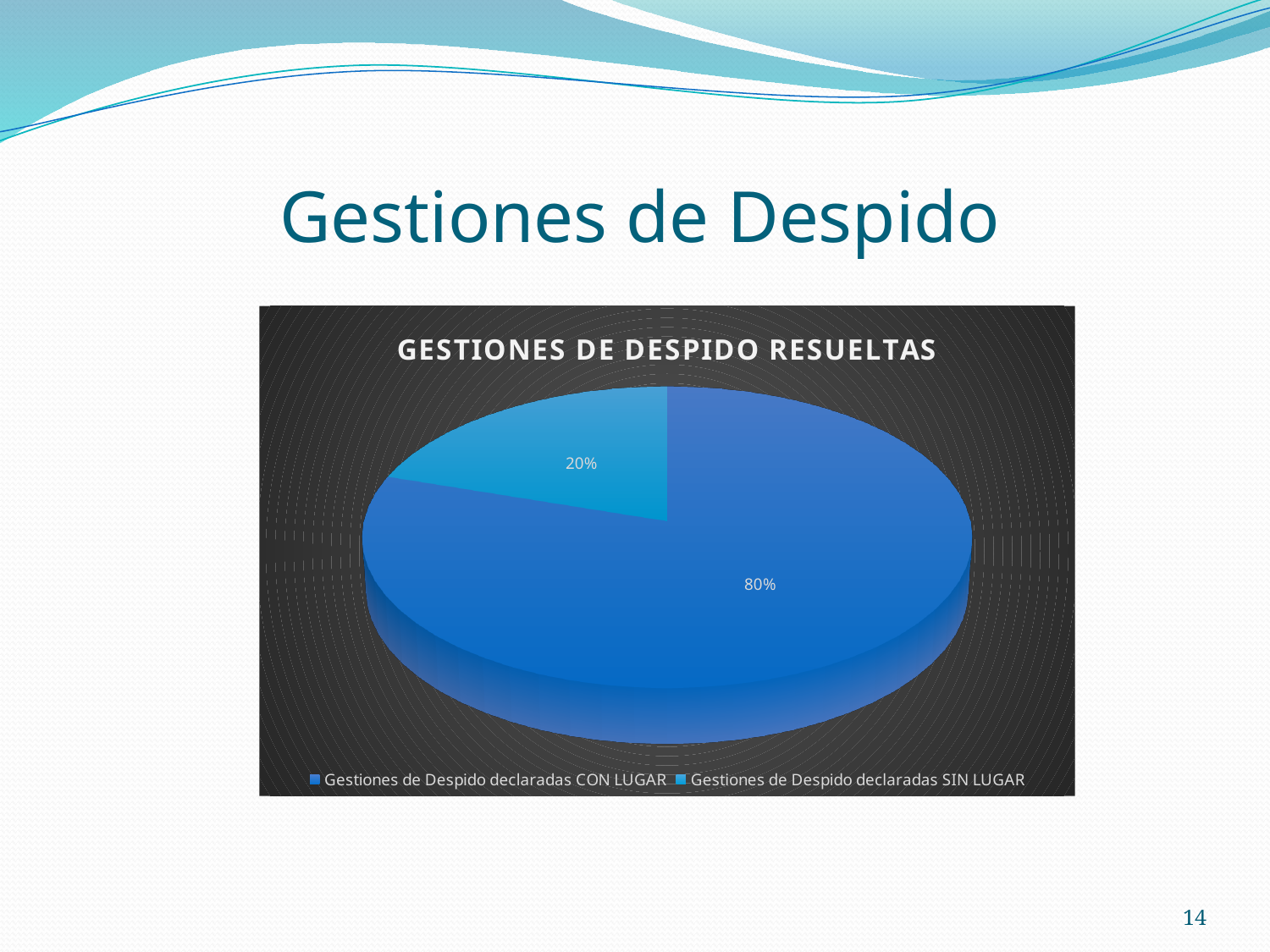
What is the difference in percentage points between the CON LUGAR slice and the SIN LUGAR slice? 60 percentage points How many slices does the pie chart have? 2 Is the share for Gestiones de Despido declaradas SIN LUGAR greater or less than 50%? less Which is larger: the slice for declaradas CON LUGAR or the slice for declaradas SIN LUGAR? Gestiones de Despido declaradas CON LUGAR How many entries does the legend list? 2 Which category has the largest slice of the pie? Gestiones de Despido declaradas CON LUGAR Which category has the smallest slice of the pie? Gestiones de Despido declaradas SIN LUGAR What is the title of the chart? GESTIONES DE DESPIDO RESUELTAS What share of the pie is labelled for Gestiones de Despido declaradas SIN LUGAR? 20% What kind of chart is shown on the slide? Pie chart What share of the pie is labelled for Gestiones de Despido declaradas CON LUGAR? 80%